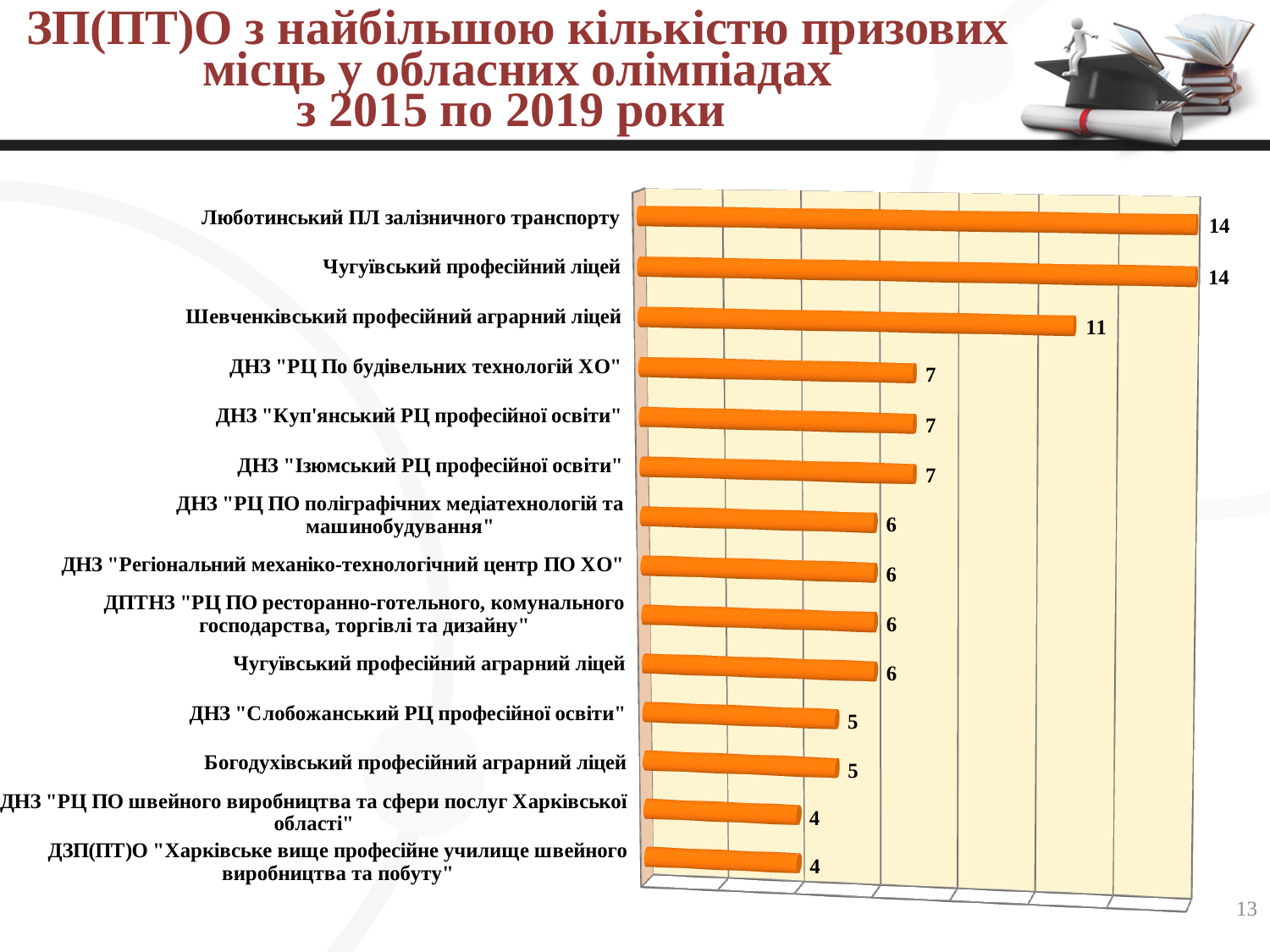
What kind of chart is shown on the slide? bar chart What is the difference between the values for Шевченківський професійний аграрний ліцей and ДНЗ "Ізюмський РЦ професійної освіти"? 4 What is the lowest value shown in the chart? 4 Do the values rise or fall going from the top bar to the bottom bar of the chart? fall What is the value for Шевченківський професійний аграрний ліцей? 11 What is the value for ДНЗ "Слобожанський РЦ професійної освіти"? 5 What is the highest value shown in the chart? 14 Which has a larger value: ДНЗ "Куп'янський РЦ професійної освіти" or Богодухівський професійний аграрний ліцей? ДНЗ "Куп'янський РЦ професійної освіти" How many institutions (categories) are plotted in the chart? 14 What is the value for Чугуївський професійний аграрний ліцей? 6 What is the difference between the values for Чугуївський професійний ліцей and Шевченківський професійний аграрний ліцей? 3 What is the value for Люботинський ПЛ залізничного транспорту? 14